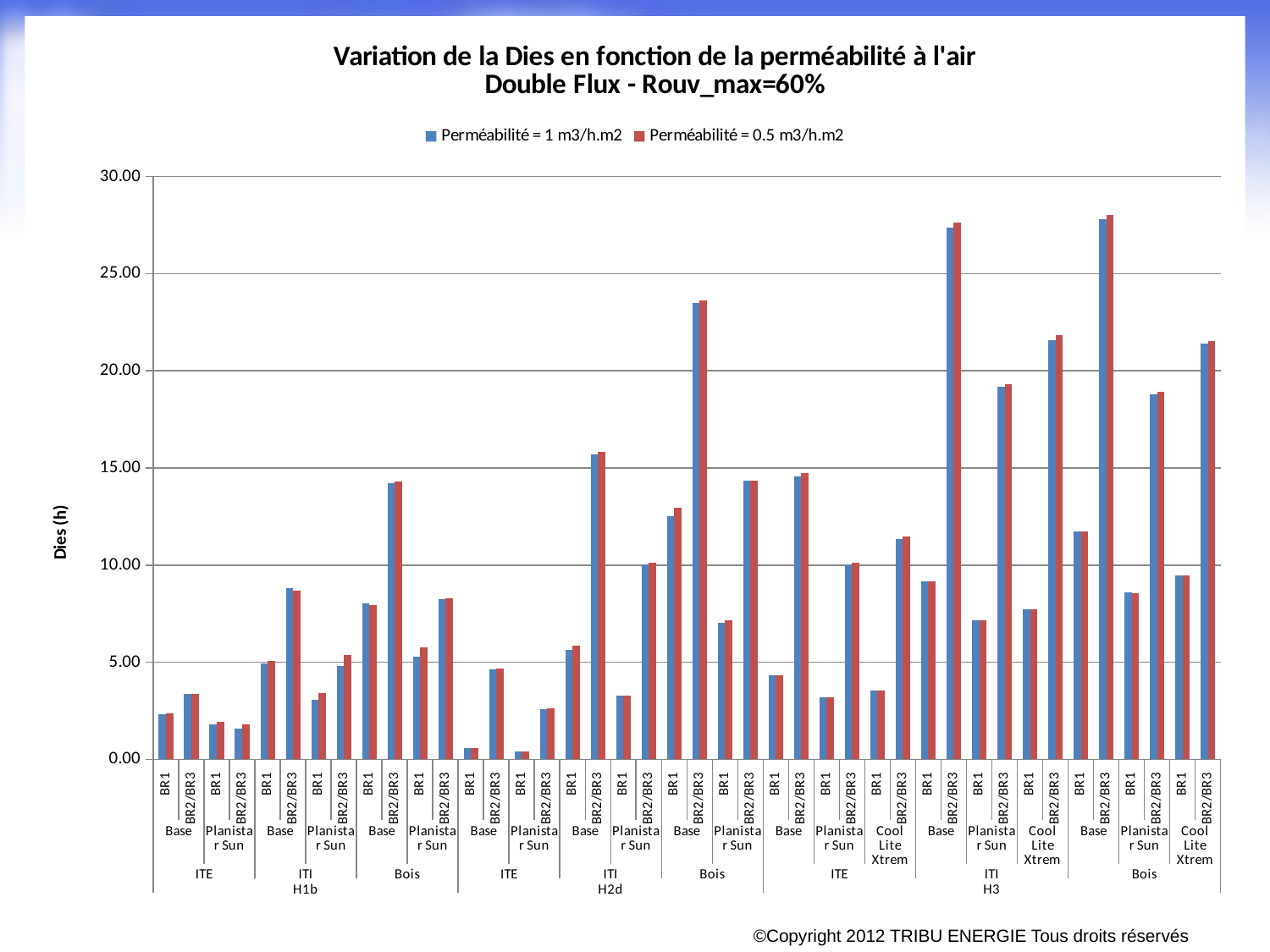
For Perméabilité = 1 m3/h.m2, which is larger: H3, ITI, Base, BR2/BR3 or H3, ITI, Planistar Sun, BR2/BR3? H3, ITI, Base, BR2/BR3 Is the value for H3, Bois, Cool Lite Xtrem, BR2/BR3 (Perméabilité = 0.5 m3/h.m2) greater or less than 20.00? greater Is the value for H1b, ITE, Base, BR1 (Perméabilité = 1 m3/h.m2) greater or less than 5.00? less Is the value for H1b, Bois, Base, BR2/BR3 (Perméabilité = 1 m3/h.m2) greater or less than 10.00? greater For Perméabilité = 0.5 m3/h.m2, which is larger: H1b, ITI, Base, BR2/BR3 or H1b, Bois, Base, BR2/BR3? H1b, Bois, Base, BR2/BR3 What are the two series named in the legend? Perméabilité = 1 m3/h.m2 and Perméabilité = 0.5 m3/h.m2 What kind of chart is shown on the slide? bar chart How many series does the legend list? 2 What is the label of the vertical axis? Dies (h)